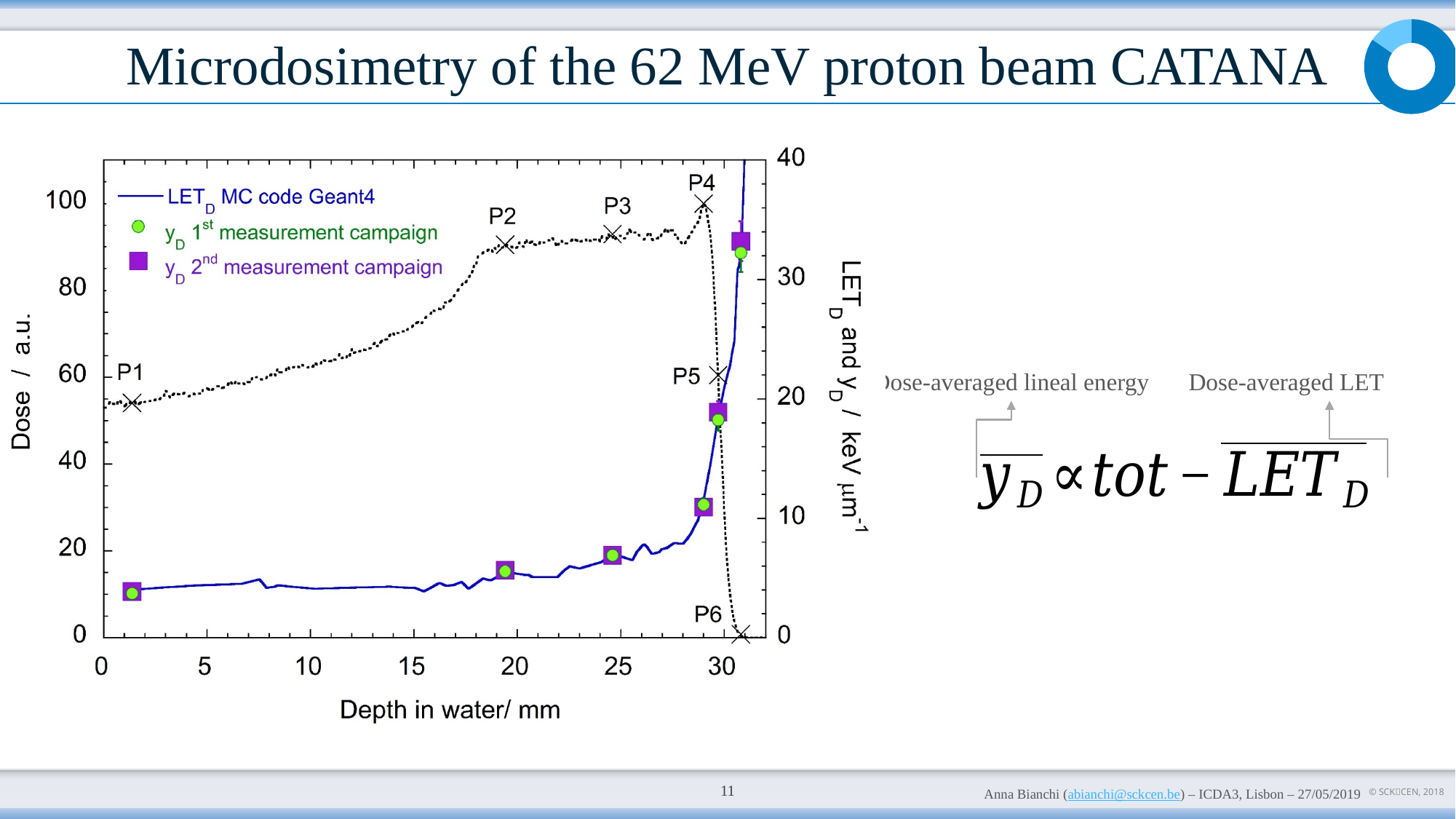
Which has the larger dose value, P2 or P6? P2 Is the dose value at P1 greater or less than 40? greater How many entries does the chart legend list? 3 What is the left y-axis title of the chart? Dose / a.u. Does the LET_D MC code Geant4 curve rise or fall as depth in water increases? rise What is the x-axis title of the chart? Depth in water/ mm Is the dose value at P4 greater or less than 80? greater What kind of chart is shown on the slide? line chart Is the dose value at P6 greater or less than 20? less How many labeled positions (P1 to P6) are marked on the dose curve? 6 Which labeled position has the lowest dose value? P6 Which labeled position has the highest dose value? P4